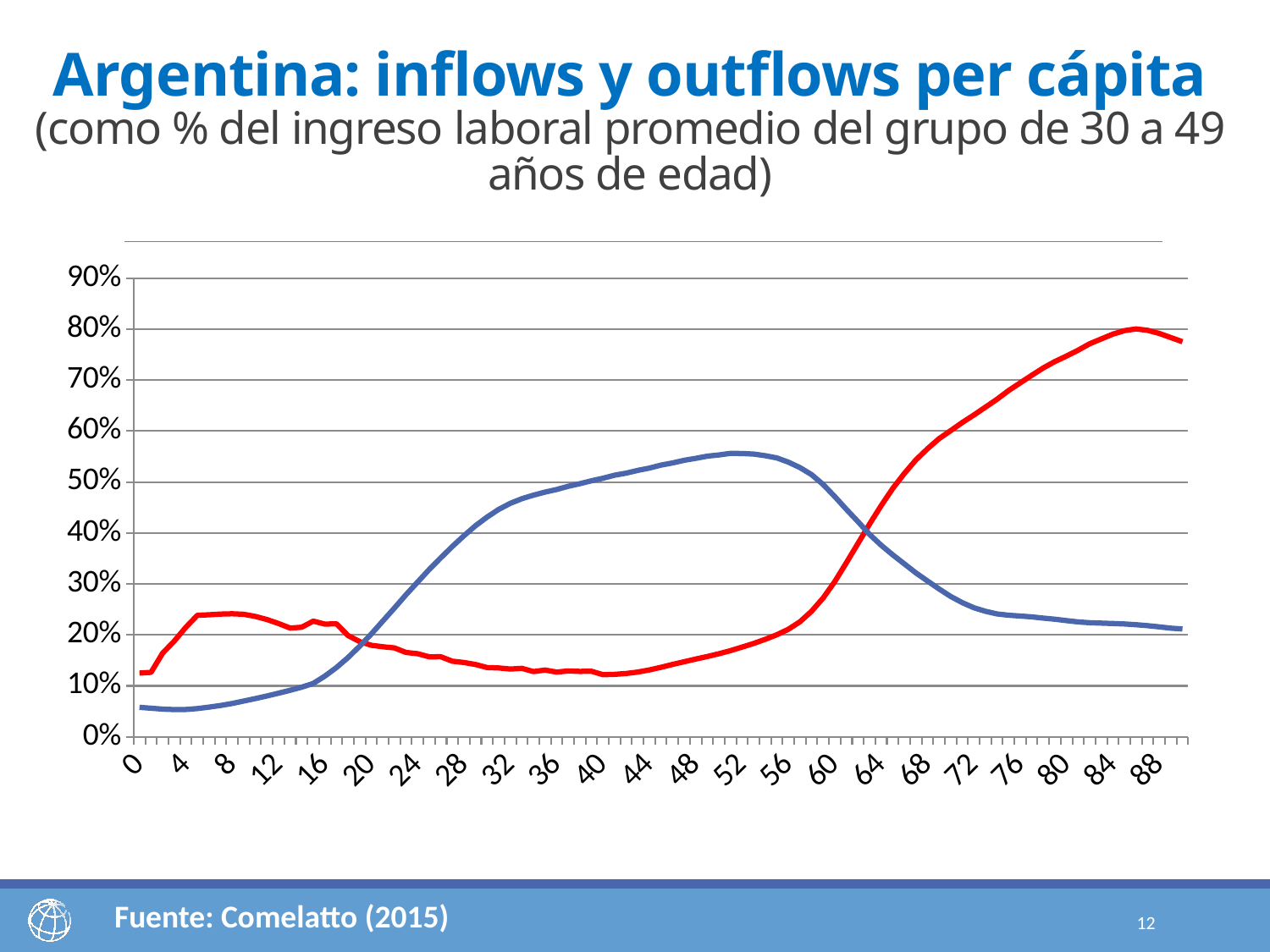
What is the source cited at the bottom of the slide? Comelatto (2015) Is the value of the red line at age 88 greater or less than 70%? greater Is the value of the red line at age 40 greater or less than 20%? less Does the blue line rise or fall between age 56 and age 88? fall Does the red line rise or fall between age 60 and age 84? rise Is the value of the blue line at age 72 greater or less than 30%? less How many lines are plotted on the chart? 2 What kind of chart is shown on the slide? line chart At age 52, which line is higher, the red line or the blue line? the blue line At age 80, which line is higher, the red line or the blue line? the red line